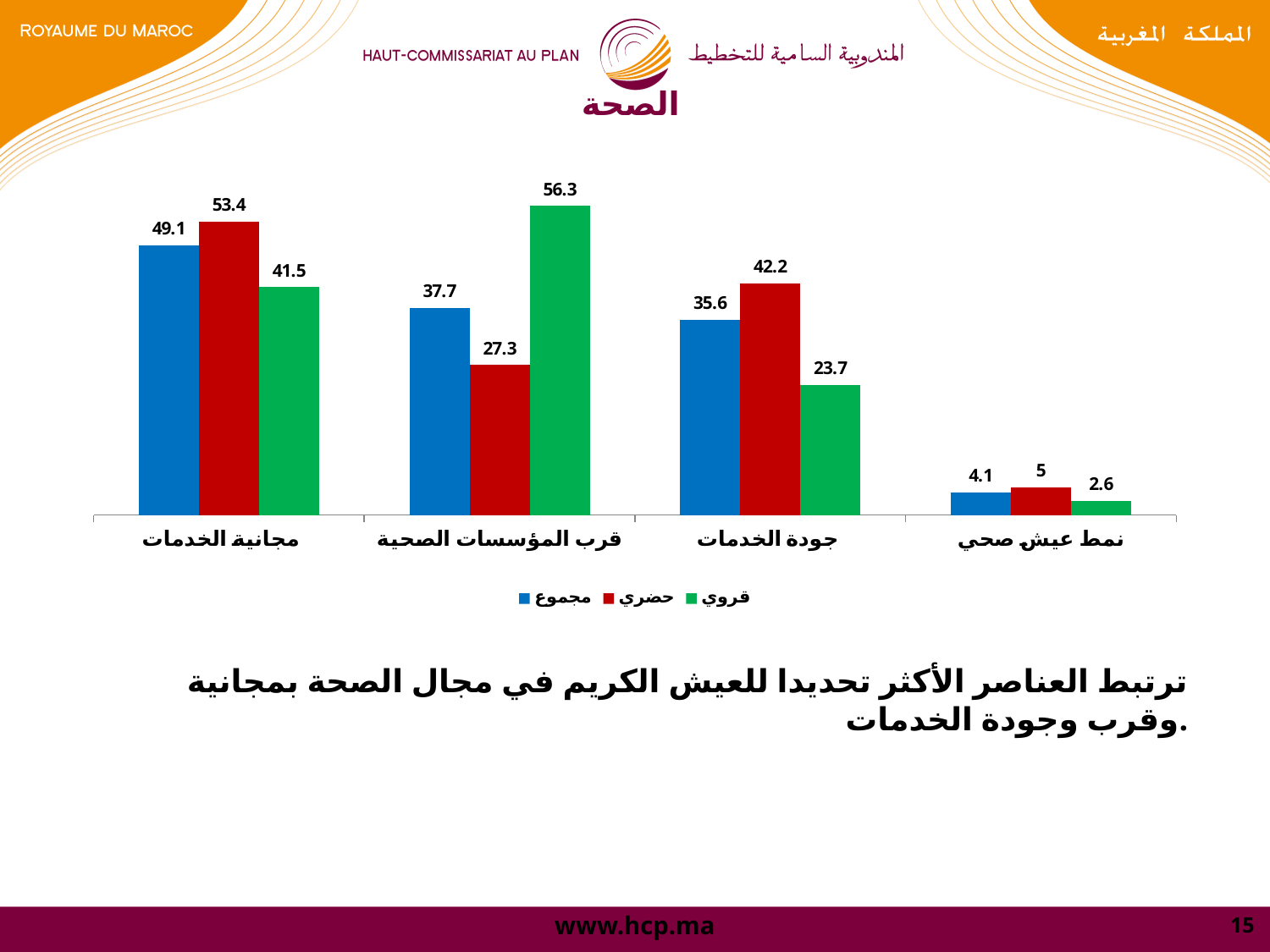
How many series does the chart's legend list? 3 Which category has the lowest value for the مجموع (total) series? نمط عيش صحي What is the difference between the حضري (urban) and قروي (rural) values for قرب المؤسسات الصحية? 29 What is the value of the مجموع (total) series for مجانية الخدمات? 49.1 Which colour represents the قروي (rural) series in the chart? green What is the value of the قروي (rural) series for قرب المؤسسات الصحية? 56.3 What is the value of the حضري (urban) series for جودة الخدمات? 42.2 What type of chart is shown on the slide? bar chart What is the value of the حضري (urban) series for نمط عيش صحي? 5 For جودة الخدمات, which is larger: the حضري (urban) value or the قروي (rural) value? حضري (urban) Which category has the highest value for the قروي (rural) series? قرب المؤسسات الصحية How many categories are shown on the x axis of the chart? 4